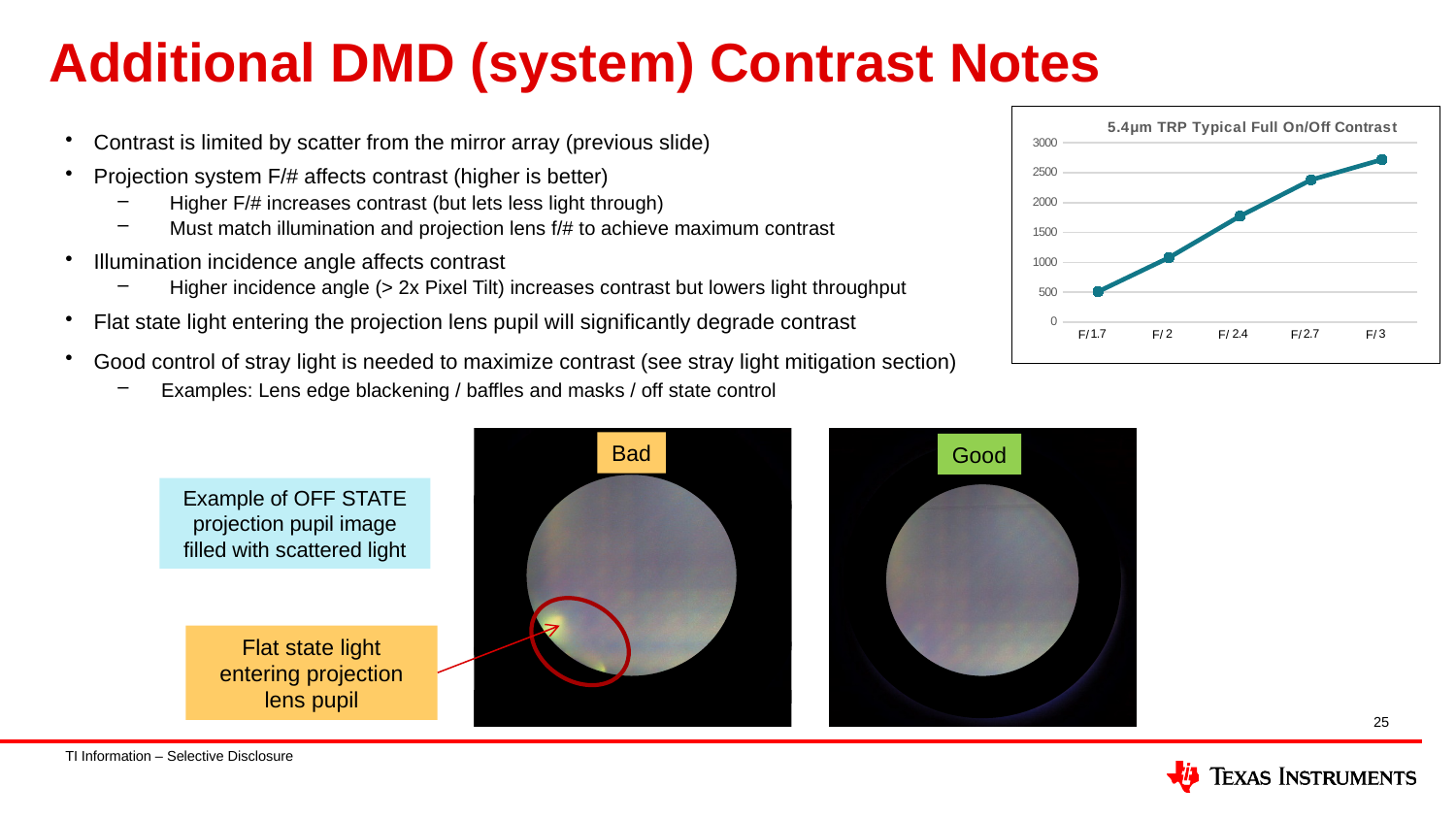
What is the title of the chart? 5.4µm TRP Typical Full On/Off Contrast Is the contrast value for F/2.7 greater or less than 2000? greater Do the contrast values rise or fall as F/# increases along the x axis? rise Which has a higher contrast value, F/2 or F/2.7? F/2.7 Which F/# has the highest contrast value? F/3 Is the contrast value for F/3 greater or less than 3000? less What is the highest value shown on the chart's y axis? 3000 How many F/# points are plotted on the chart? 5 Is the contrast value for F/2.4 greater or less than 1500? greater Which F/# has the lowest contrast value? F/1.7 What kind of chart is shown on the slide? line chart